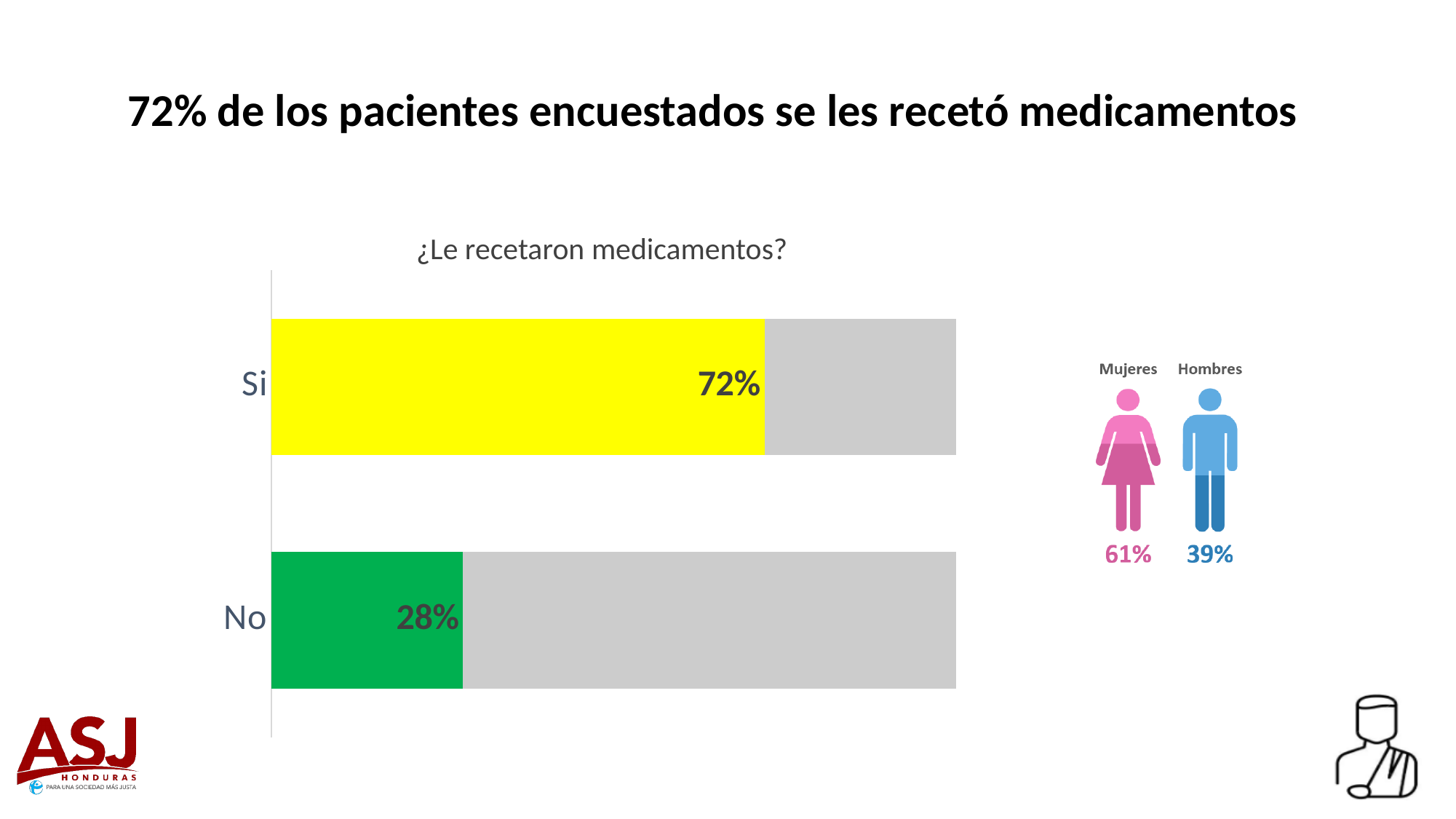
In the chart '¿Le recetaron medicamentos?', which is larger, the value for 'Si' or the value for 'No'? Si In the chart '¿Le recetaron medicamentos?', which category has the lowest value? No What is the total of the values for 'Si' and 'No' in the chart '¿Le recetaron medicamentos?'? 100% In the chart '¿Le recetaron medicamentos?', what is the difference between the values for 'Si' and 'No'? 44% How many categories does the chart '¿Le recetaron medicamentos?' show? 2 In the chart '¿Le recetaron medicamentos?', which category has the highest value? Si What kind of chart is '¿Le recetaron medicamentos?'? bar chart In the chart '¿Le recetaron medicamentos?', what colour is the bar for 'Si'? yellow What is the title of the bar chart on the slide? ¿Le recetaron medicamentos? In the pictogram on the right of the slide, what is the value shown for 'Mujeres'? 61% In the chart '¿Le recetaron medicamentos?', what is the value for 'Si'? 72% In the chart '¿Le recetaron medicamentos?', what is the value for 'No'? 28%